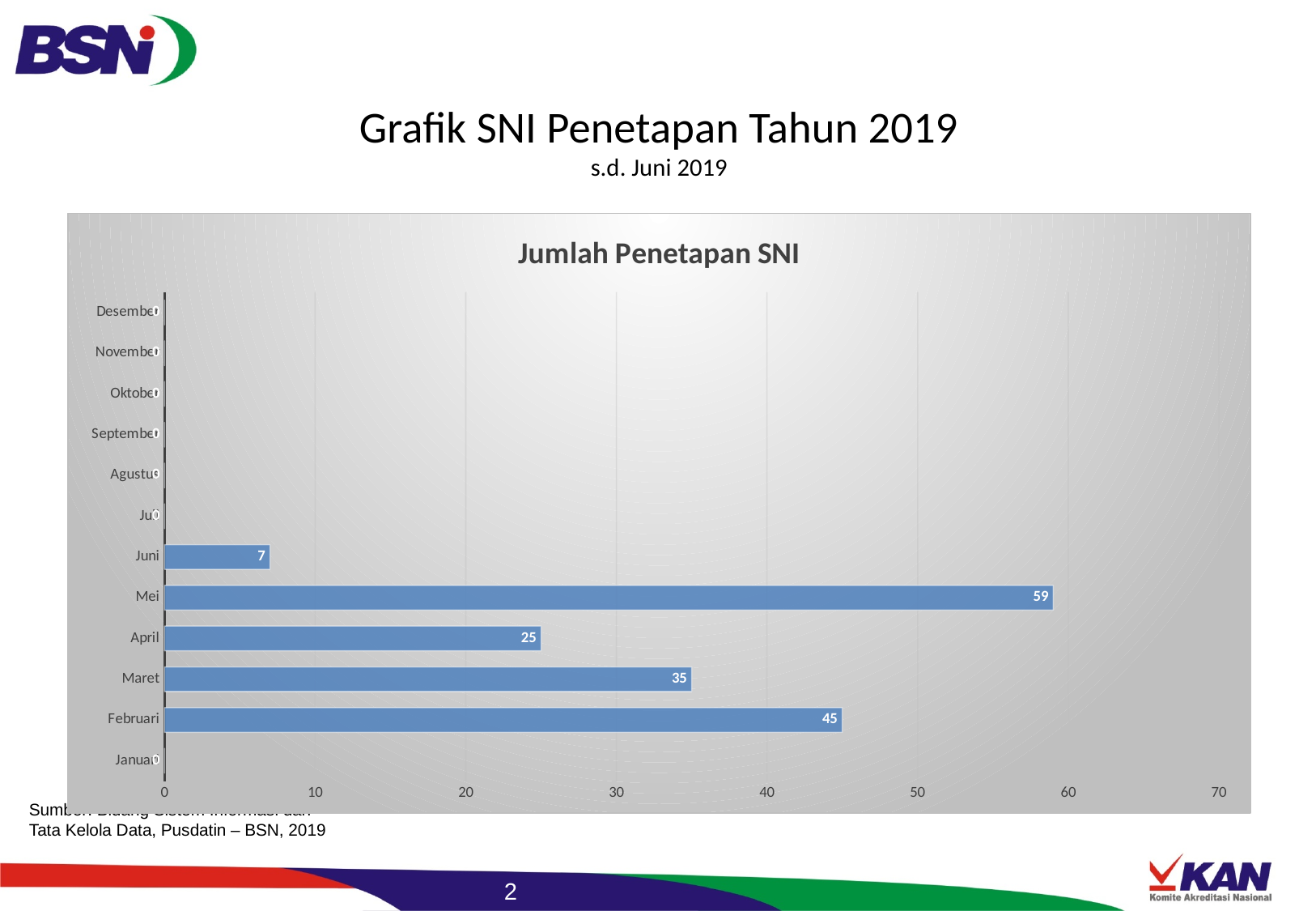
Which month has the highest value in the Jumlah Penetapan SNI chart? Mei What is the value for Mei in the Jumlah Penetapan SNI chart? 59 What is the value for Juni in the Jumlah Penetapan SNI chart? 7 Which is larger, the value for Februari or the value for Maret? Februari What is the value for Maret in the Jumlah Penetapan SNI chart? 35 Is the value for Mei greater or less than 50? greater What is the difference between the values for Maret and April? 10 What is the value for April in the Jumlah Penetapan SNI chart? 25 What kind of chart is shown on the slide? Bar chart What is the value for Februari in the Jumlah Penetapan SNI chart? 45 What is the difference between the values for Mei and Februari? 14 How many month categories are shown on the y axis of the chart? 12